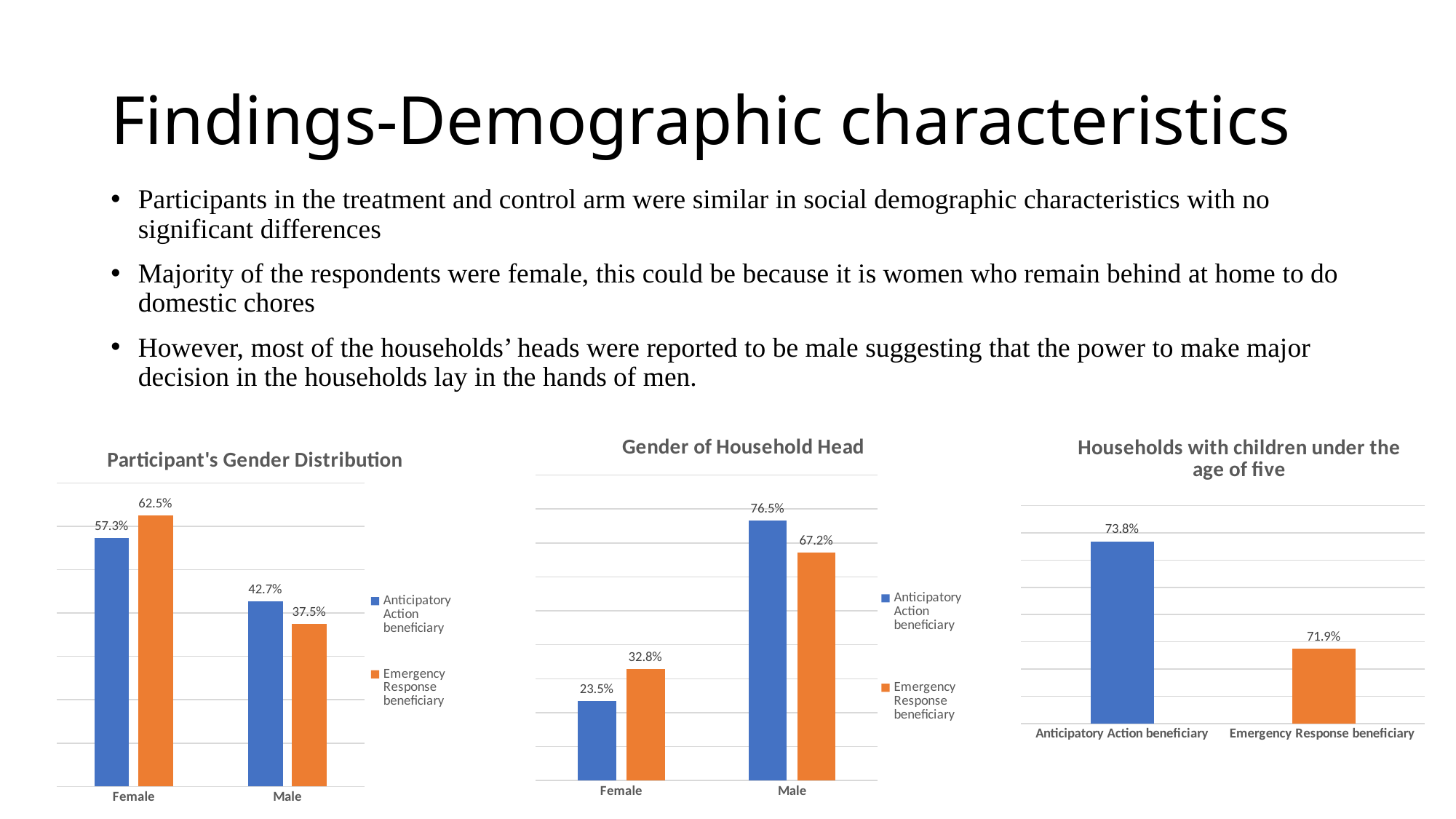
In the 'Gender of Household Head' chart, which category has the lowest value? Female, Anticipatory Action beneficiary (23.5%) In the 'Gender of Household Head' chart, what is the value for Female among Emergency Response beneficiaries? 32.8% In the 'Participant's Gender Distribution' chart, what is the value for Female among Anticipatory Action beneficiaries? 57.3% How many charts are shown on the slide? 3 In the 'Households with children under the age of five' chart, what is the difference between the Anticipatory Action beneficiary and Emergency Response beneficiary values? 1.9% In the 'Households with children under the age of five' chart, what is the value for Emergency Response beneficiary? 71.9% In the 'Participant's Gender Distribution' chart, what is the value for Male among Emergency Response beneficiaries? 37.5% In the 'Participant's Gender Distribution' chart, what is the difference between the Female values for Emergency Response beneficiaries and Anticipatory Action beneficiaries? 5.2% What kind of chart is the 'Households with children under the age of five' chart? Bar chart In the 'Gender of Household Head' chart, which is larger for Male: Anticipatory Action beneficiary or Emergency Response beneficiary? Anticipatory Action beneficiary How many series does the legend of the 'Participant's Gender Distribution' chart list? 2 In the 'Gender of Household Head' chart, what is the value for Male among Anticipatory Action beneficiaries? 76.5%